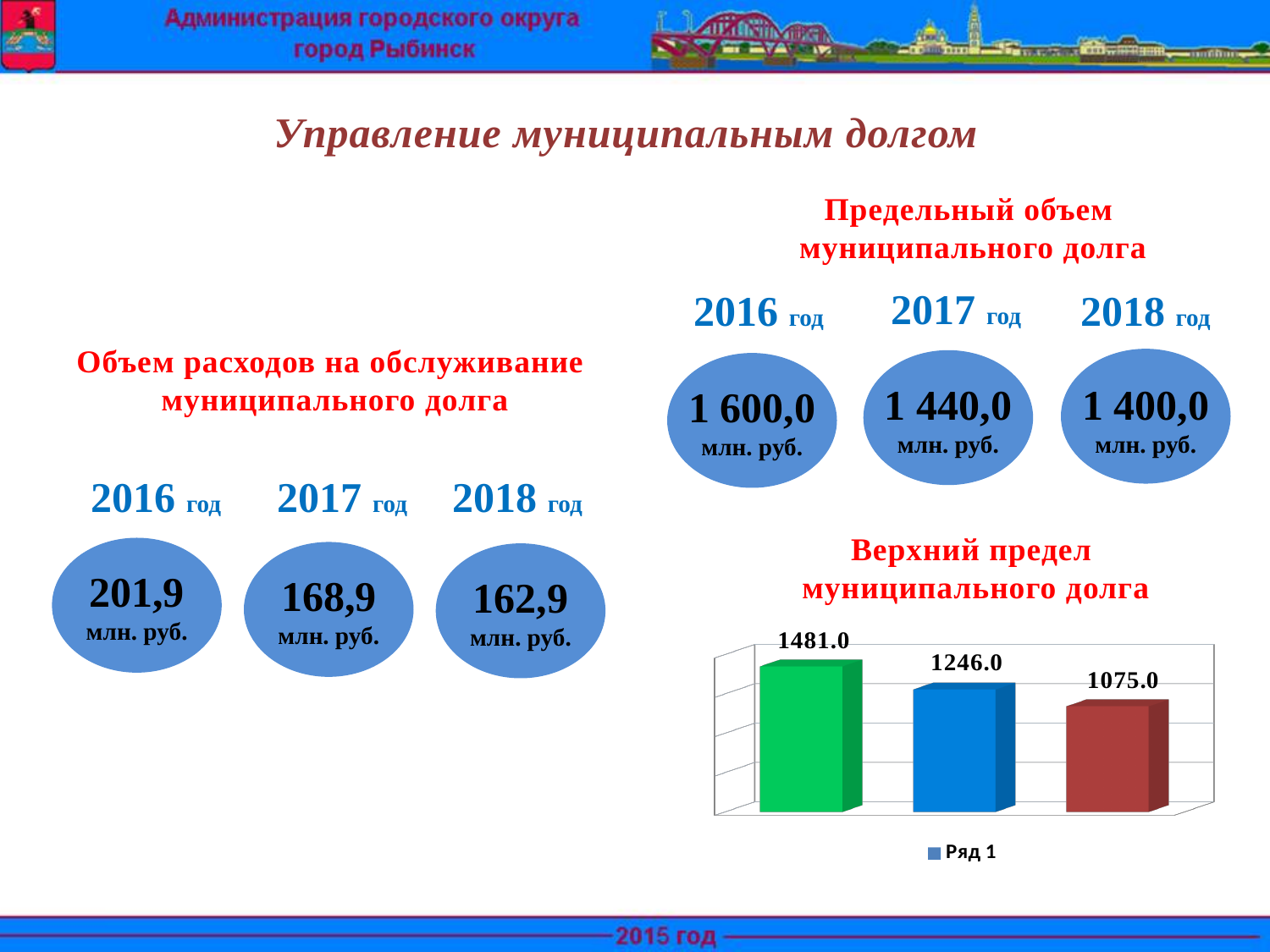
What is the value shown on the middle (blue) bar in the "Верхний предел муниципального долга" chart? 1246.0 What kind of chart is shown under the heading "Верхний предел муниципального долга"? bar chart Do the values in the "Верхний предел муниципального долга" chart rise or fall from left to right? fall Which bar has the lowest value in the "Верхний предел муниципального долга" chart? the rightmost (red) bar, 1075.0 How many series does the legend of the "Верхний предел муниципального долга" chart list? 1 What is the legend entry shown below the "Верхний предел муниципального долга" chart? Ряд 1 How many bars are plotted in the "Верхний предел муниципального долга" chart? 3 What is the value shown on the rightmost (red) bar in the "Верхний предел муниципального долга" chart? 1075.0 In the "Верхний предел муниципального долга" chart, what is the difference between the leftmost bar and the rightmost bar? 406.0 Which bar has the highest value in the "Верхний предел муниципального долга" chart? the leftmost (green) bar, 1481.0 In the "Верхний предел муниципального долга" chart, which is larger: the middle bar or the rightmost bar? the middle bar (1246.0) What is the value shown on the leftmost (green) bar in the "Верхний предел муниципального долга" chart? 1481.0